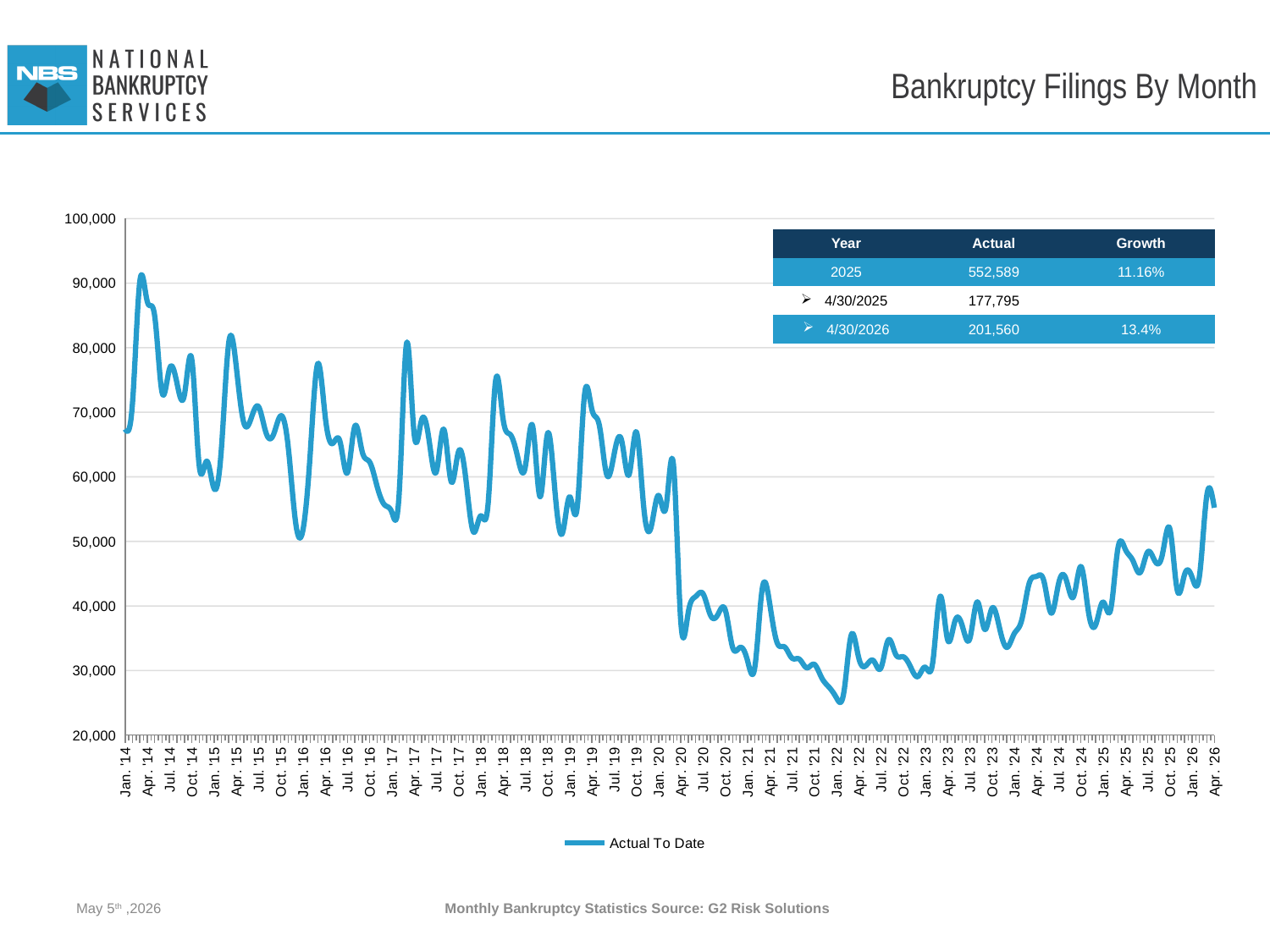
Do the values generally rise or fall between Jan. '20 and Apr. '20? fall Is the value for Apr. '26 greater or less than 50,000? greater Is the value for Apr. '14 greater or less than 80,000? greater According to the table on the chart, what is the Actual value for 2025? 552,589 Is the value for Jan. '22 greater or less than 30,000? less What is the title of the chart? Bankruptcy Filings By Month According to the table on the chart, what is the Growth shown for 4/30/2026? 13.4% What is the name of the series shown in the legend? Actual To Date Which is larger, the value for Apr. '14 or the value for Apr. '26? Apr. '14 What kind of chart is shown on the slide? line chart How many series does the legend list? 1